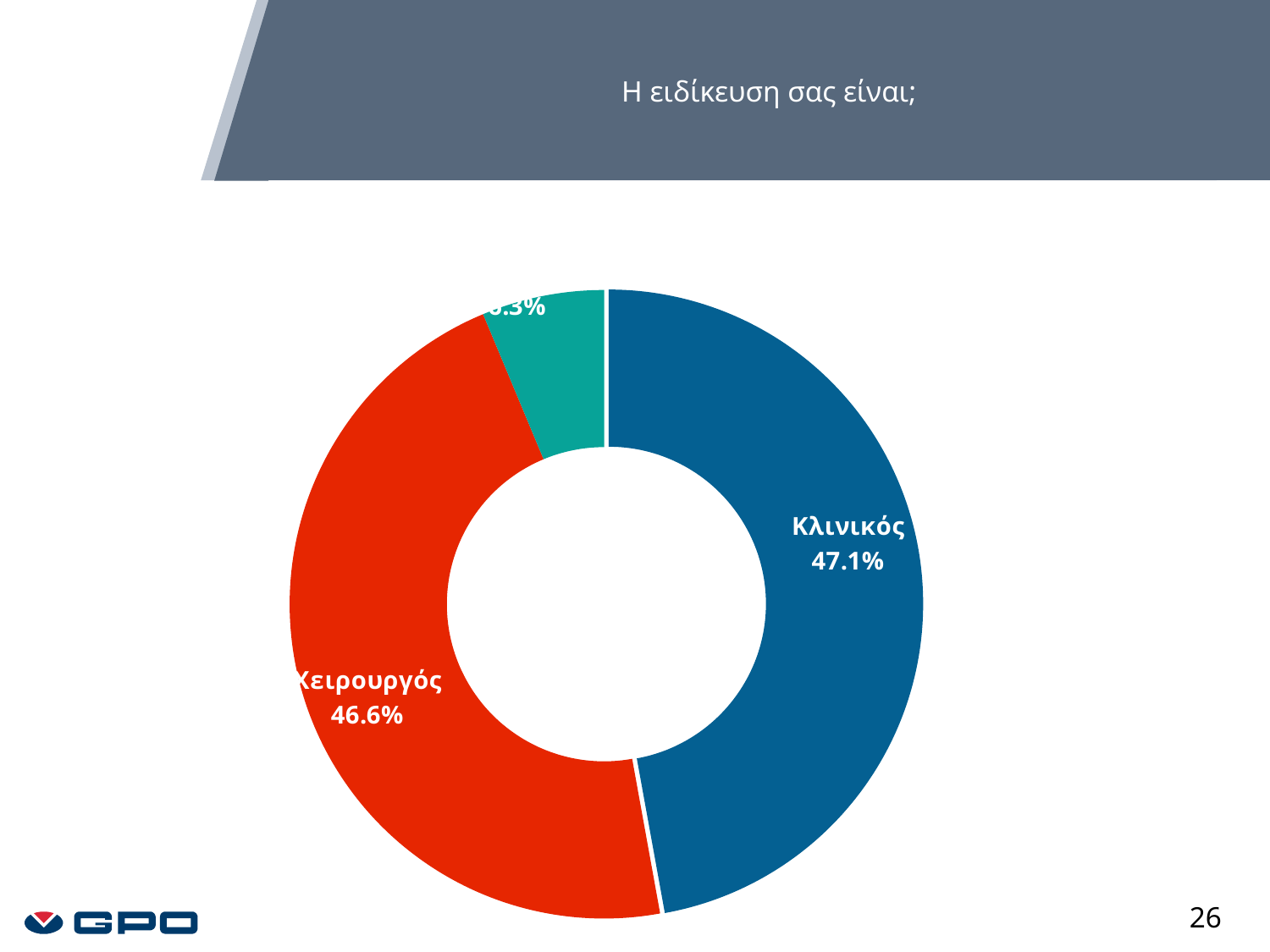
Which labelled category has the largest share in the chart? Κλινικός What colour is the slice for Κλινικός? Blue What is the difference in percentage points between Κλινικός and Χειρουργός? 0.5 How many slices does the chart have? 3 What percentage of respondents answered Κλινικός? 47.1% What percentage of respondents answered Χειρουργός? 46.6% Which is larger, the share for Κλινικός or the share for Χειρουργός? Κλινικός What is the title of the slide? Η ειδίκευση σας είναι; What kind of chart is shown on the slide? Pie (doughnut) chart